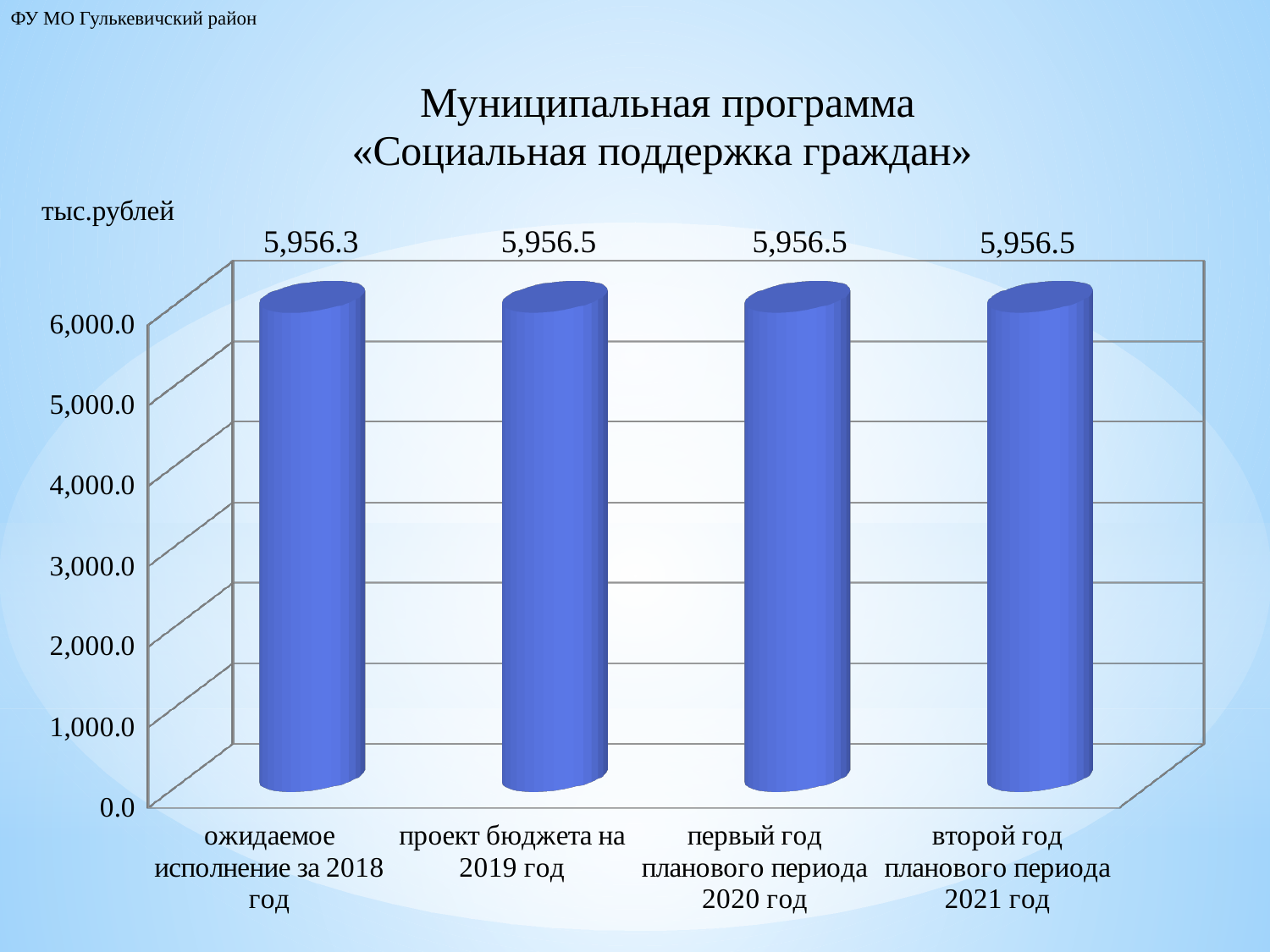
In what units are the values on the chart given? тыс.рублей What is the value for первый год планового периода 2020 год? 5,956.5 What is the title of the chart? Муниципальная программа «Социальная поддержка граждан» What kind of chart is shown on the slide? bar chart What is the value for проект бюджета на 2019 год? 5,956.5 What is the value for ожидаемое исполнение за 2018 год? 5,956.3 Is the value for проект бюджета на 2019 год greater or less than 5,000.0? greater What is the value for второй год планового периода 2021 год? 5,956.5 How many categories are shown on the chart? 4 What is the difference between the value for проект бюджета на 2019 год and the value for ожидаемое исполнение за 2018 год? 0.2 Which category has the lowest value? ожидаемое исполнение за 2018 год